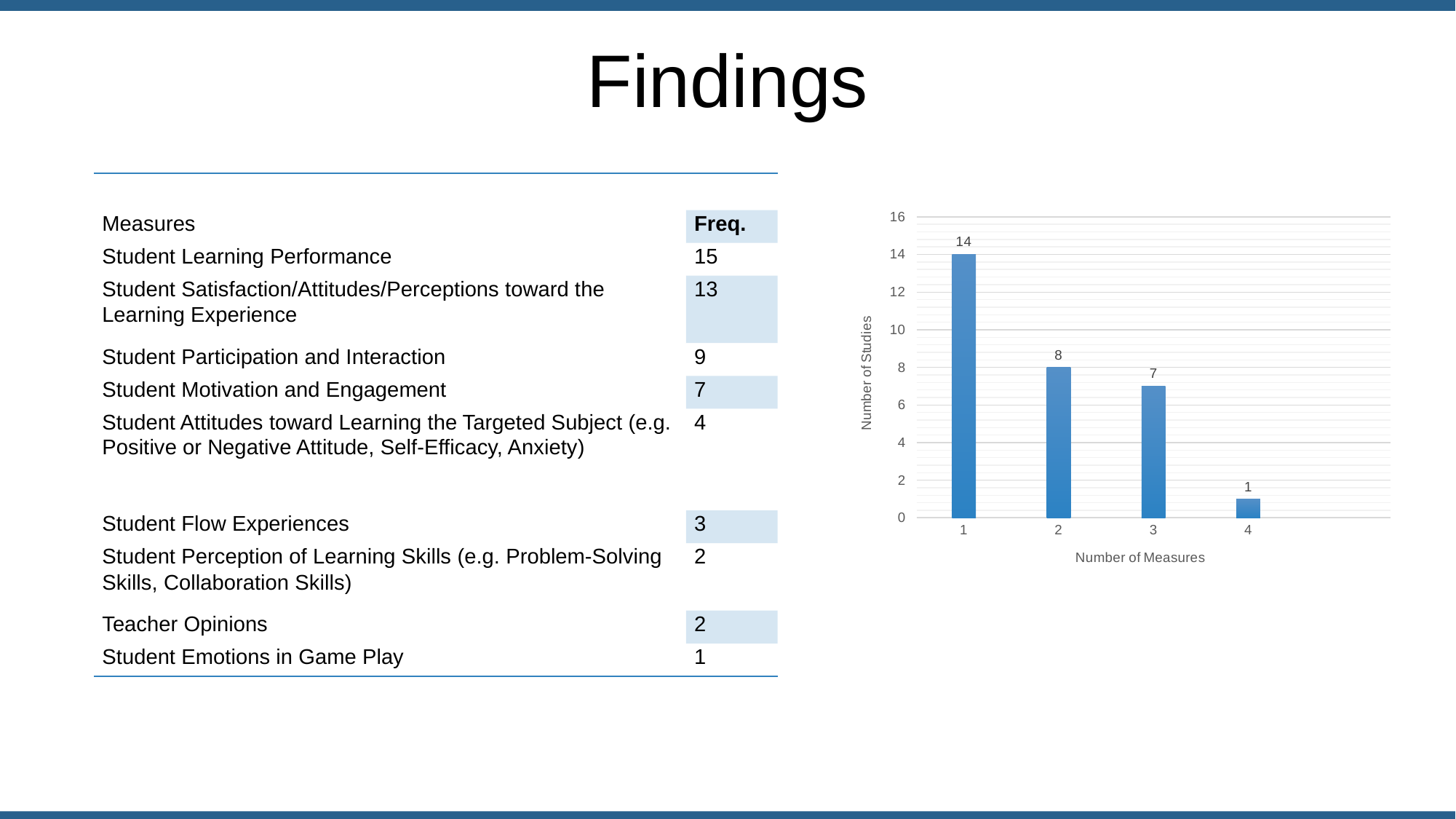
What is the number of studies for 3 measures? 7 What kind of chart is shown on the slide? bar chart Is the number of studies for 2 measures greater or less than 10? less What is the number of studies for 4 measures? 1 Which has more studies: 2 measures or 3 measures? 2 measures Which number of measures has the highest number of studies? 1 What is the label of the x axis of the chart? Number of Measures Which number of measures has the lowest number of studies? 4 Do the values rise or fall as the number of measures increases? fall What is the number of studies for 1 measure? 14 What is the difference in number of studies between 1 measure and 2 measures? 6 How many bars are shown in the chart? 4